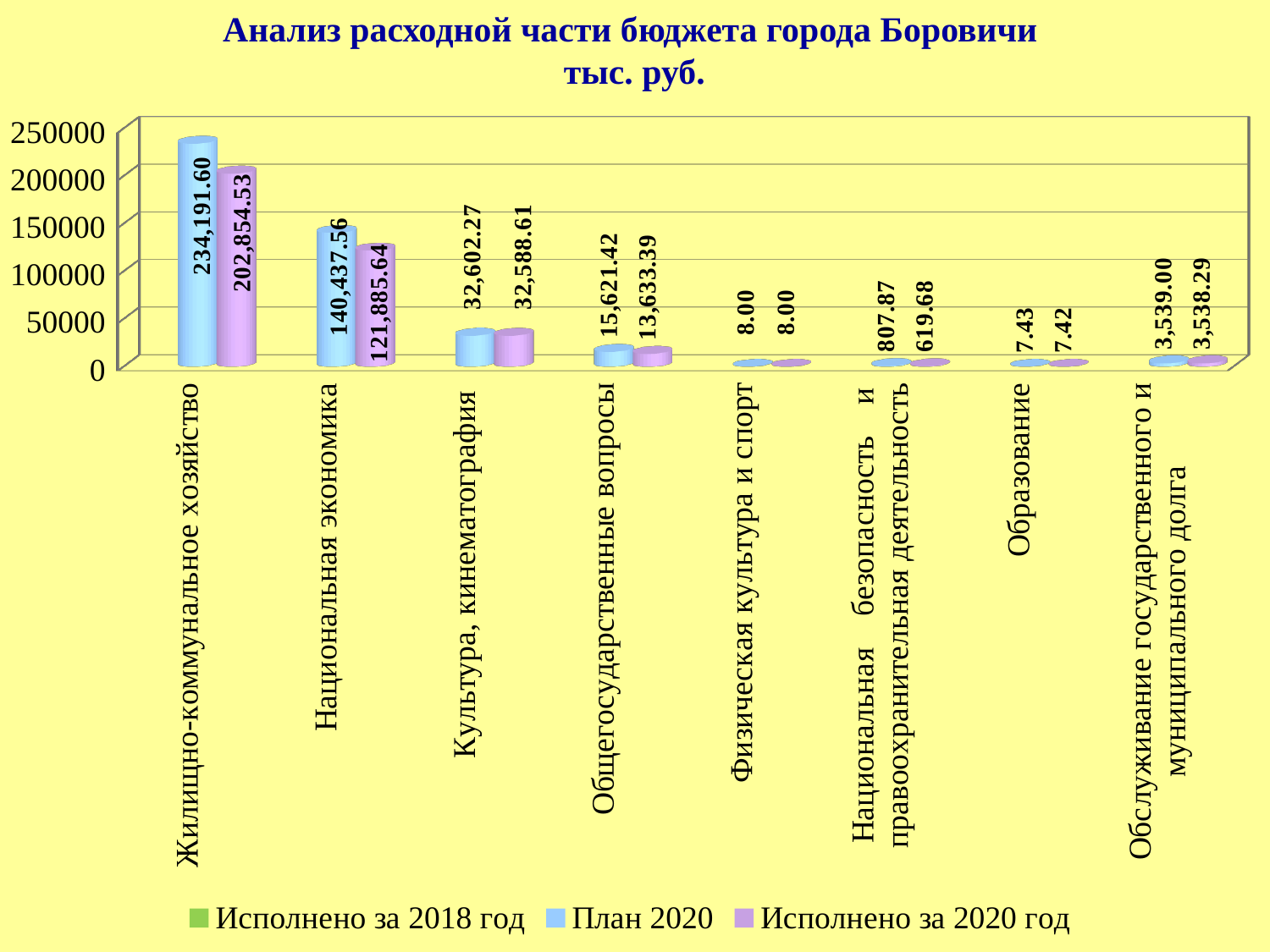
What is the difference between План 2020 and Исполнено за 2020 год for Жилищно-коммунальное хозяйство? 31,337.07 What is the Исполнено за 2020 год value for Национальная безопасность и правоохранительная деятельность? 619.68 What is the difference between План 2020 and Исполнено за 2020 год for Национальная экономика? 18,551.92 What is the План 2020 value for Жилищно-коммунальное хозяйство? 234,191.60 What type of chart is shown on the slide? bar chart What is the Исполнено за 2020 год value for Национальная экономика? 121,885.64 How many series does the legend list? 3 Which is larger for Общегосударственные вопросы: План 2020 or Исполнено за 2020 год? План 2020 Which category has the highest План 2020 value? Жилищно-коммунальное хозяйство Which category has the lowest Исполнено за 2020 год value? Образование What is the title of the chart? Анализ расходной части бюджета города Боровичи тыс. руб. How many categories are shown on the x axis? 8